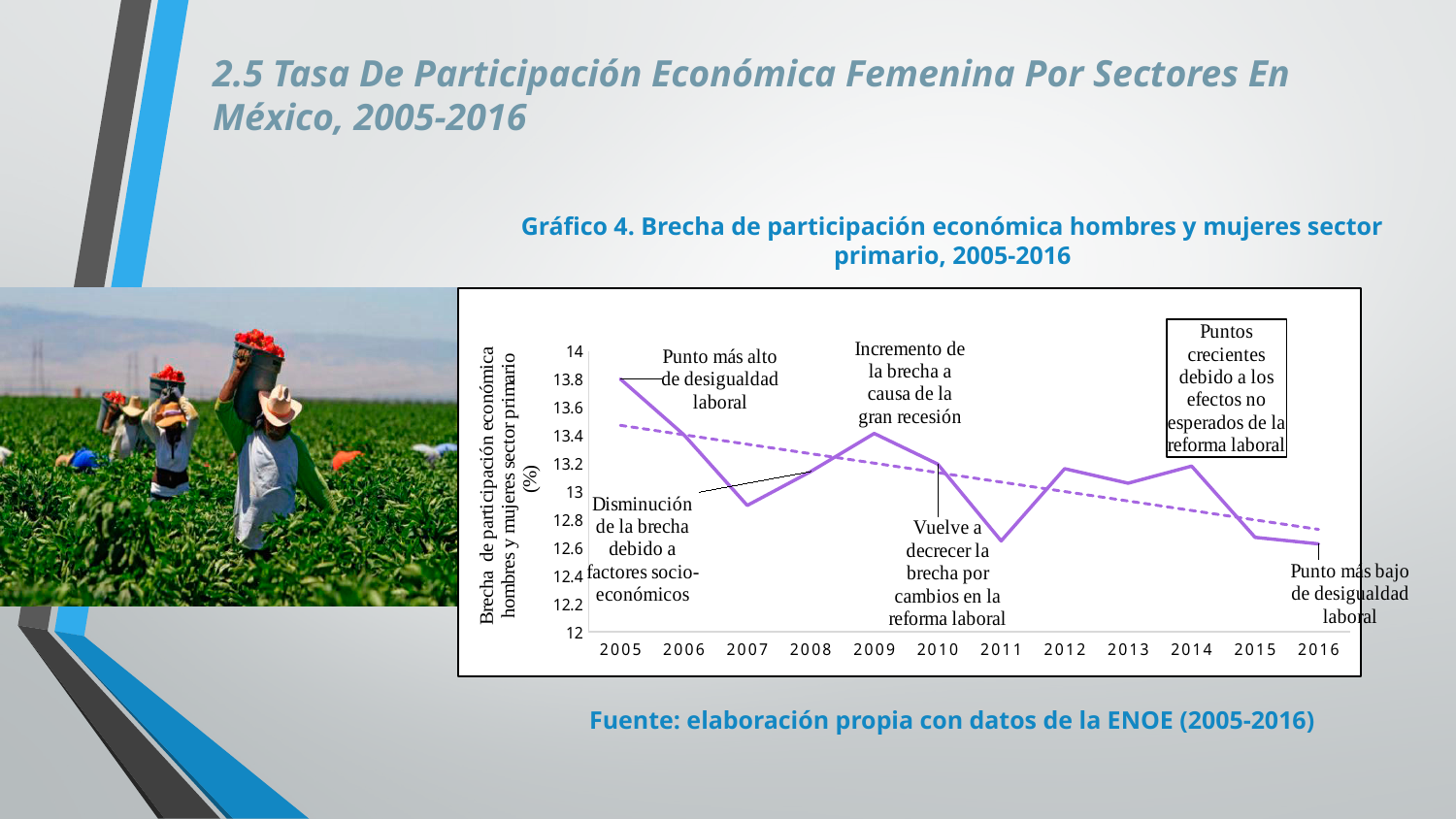
Is the value for 2005 greater or less than 13.6? greater Is the value for 2016 greater or less than 12.8? less What kind of chart is shown on the slide? Line chart Which year has a larger value, 2005 or 2016? 2005 In which year is the gap (brecha) highest? 2005 Which year has a larger value, 2009 or 2011? 2009 In which year is the gap (brecha) lowest? 2016 Does the gap generally rise or fall from 2005 to 2016? Fall What is the title of the chart? Gráfico 4. Brecha de participación económica hombres y mujeres sector primario, 2005-2016 Is the value for 2009 greater or less than 13.2? greater How many years are plotted along the x axis of the chart? 12